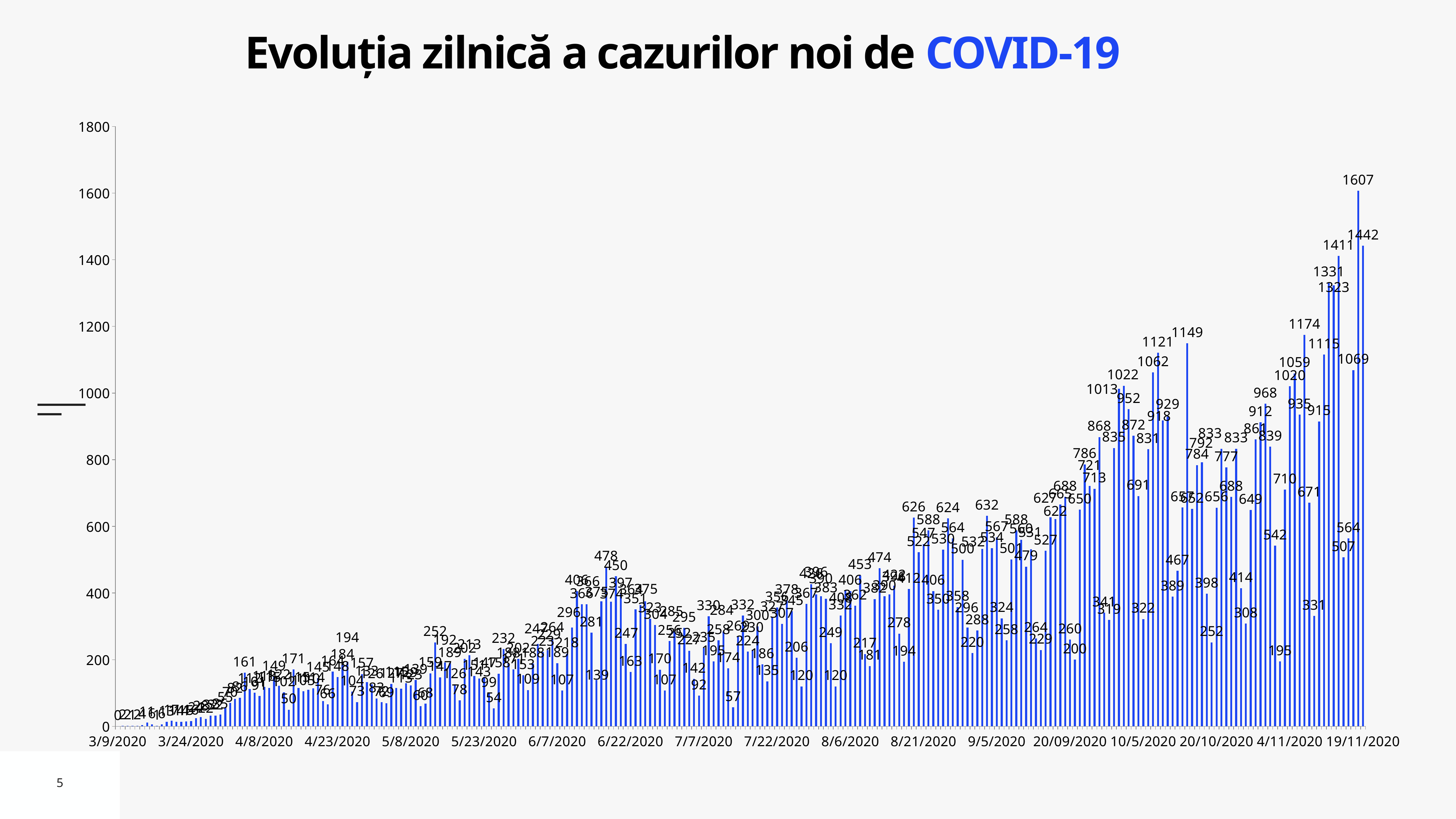
Overall, do the daily values rise or fall from left to right along the x axis? rise What is the title of the chart? Evoluția zilnică a cazurilor noi de COVID-19 Is the value for 19/11/2020 greater or less than 1200? greater Is the value for 3/24/2020 greater or less than 200? less What is the highest value marked on the vertical axis? 1800 Is the value for 7/7/2020 greater or less than 600? less Which is larger, the highest value on the chart or 1442? the highest value (1607) What kind of chart is shown on the slide? bar chart What is the highest daily value shown on the chart? 1607 What is the lowest value shown on the chart? 0 What is the difference between the highest value (1607) and the second highest value (1442)? 165 What is the value for the first date, 3/9/2020? 0